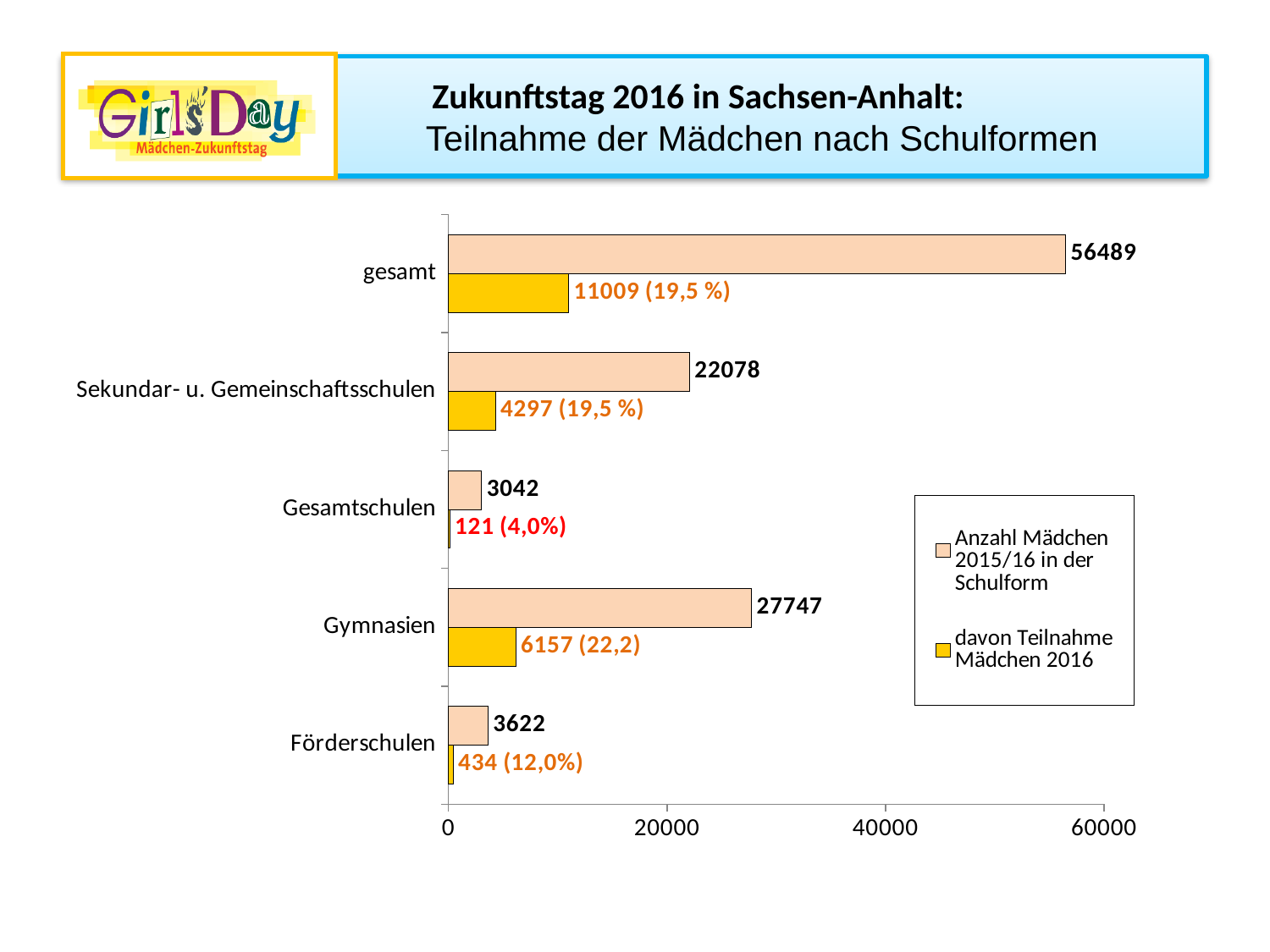
Which is larger: the 'Anzahl Mädchen 2015/16 in der Schulform' value for Förderschulen or for Gesamtschulen? Förderschulen What is the value of 'Anzahl Mädchen 2015/16 in der Schulform' for Gymnasien? 27747 What is the value of 'davon Teilnahme Mädchen 2016' for Sekundar- u. Gemeinschaftsschulen? 4297 Which school type has the lowest value for 'davon Teilnahme Mädchen 2016'? Gesamtschulen What is the value of 'Anzahl Mädchen 2015/16 in der Schulform' for gesamt? 56489 What percentage is shown next to the 'davon Teilnahme Mädchen 2016' bar for Gesamtschulen? 4,0% What kind of chart is shown on the slide? bar chart What is the difference between the 'Anzahl Mädchen 2015/16 in der Schulform' values for Gymnasien and Sekundar- u. Gemeinschaftsschulen? 5669 Excluding the 'gesamt' row, which school type has the highest value for 'Anzahl Mädchen 2015/16 in der Schulform'? Gymnasien How many series does the legend list? 2 How many categories are shown on the vertical axis of the chart? 5 Is the 'davon Teilnahme Mädchen 2016' value for gesamt greater or less than 20000? less